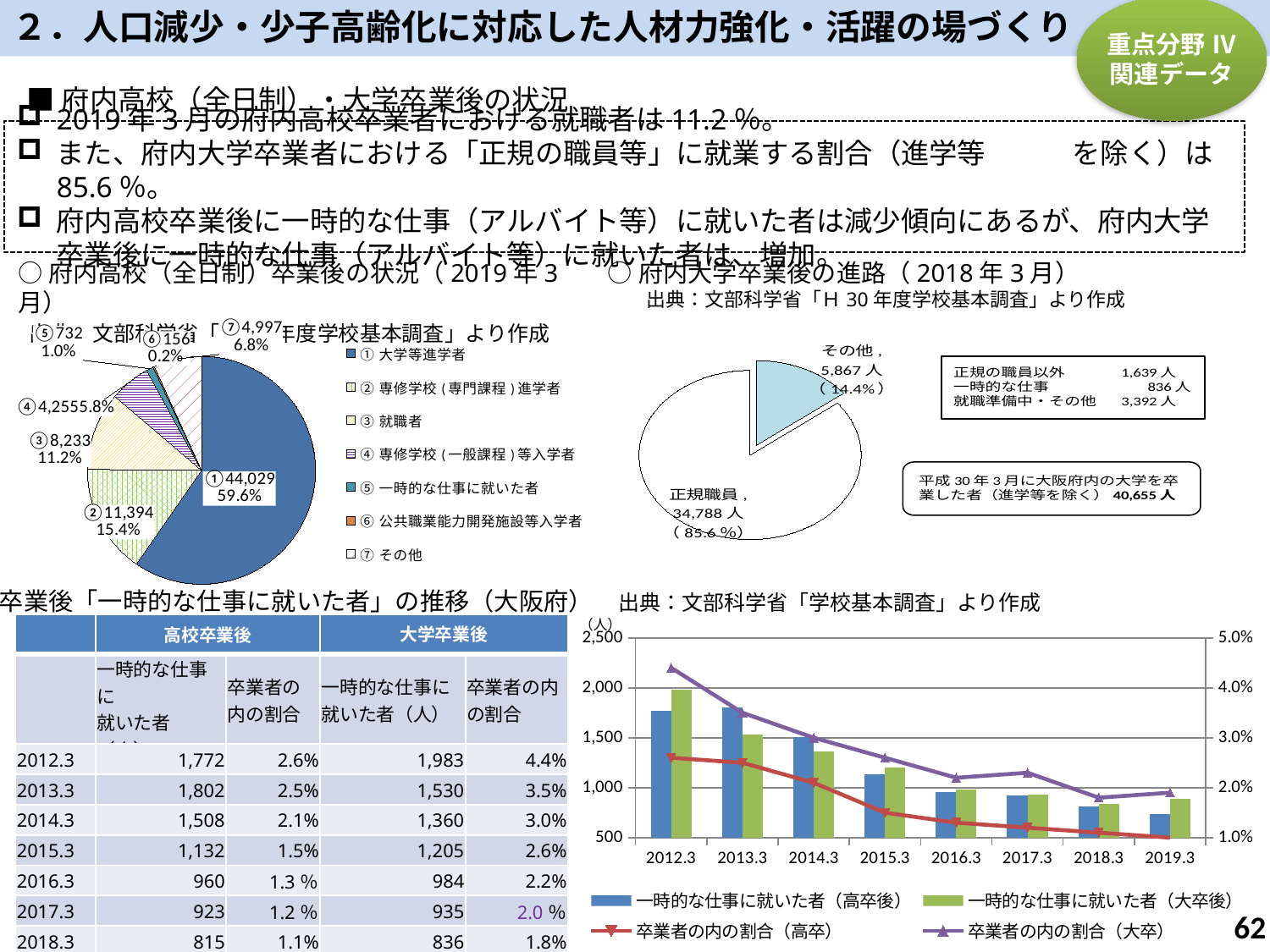
In the 府内高校（全日制）卒業後の状況 pie chart, which category has the largest slice? ① 大学等進学者 In the bottom-right chart, is the bar for 一時的な仕事に就いた者（大卒後） in 2012.3 greater or less than 1,500? greater In the 府内高校（全日制）卒業後の状況 pie chart, what share of the pie is ① 大学等進学者? 59.6% In the bottom-right chart showing the trend of 一時的な仕事に就いた者, how many years are shown on the x axis? 8 In the 府内高校（全日制）卒業後の状況 pie chart, which category has the smallest slice? ⑥ 公共職業能力開発施設等入学者 In the 府内高校（全日制）卒業後の状況 pie chart, what is the number shown for ③ 就職者? 8,233 In the 府内大学卒業後の進路 pie chart, how many people are in the その他 slice? 5,867人 How many series does the legend of the bottom-right 一時的な仕事に就いた者 chart list? 4 In the 府内大学卒業後の進路 pie chart, what share of the pie is 正規職員? 85.6% How many entries does the legend of the 府内高校（全日制）卒業後の状況 pie chart list? 7 What kind of chart is the 府内高校（全日制）卒業後の状況 chart on the left? pie chart In the bottom-right chart, do the bars for 一時的な仕事に就いた者（高卒後） generally rise or fall from 2012.3 to 2019.3? fall